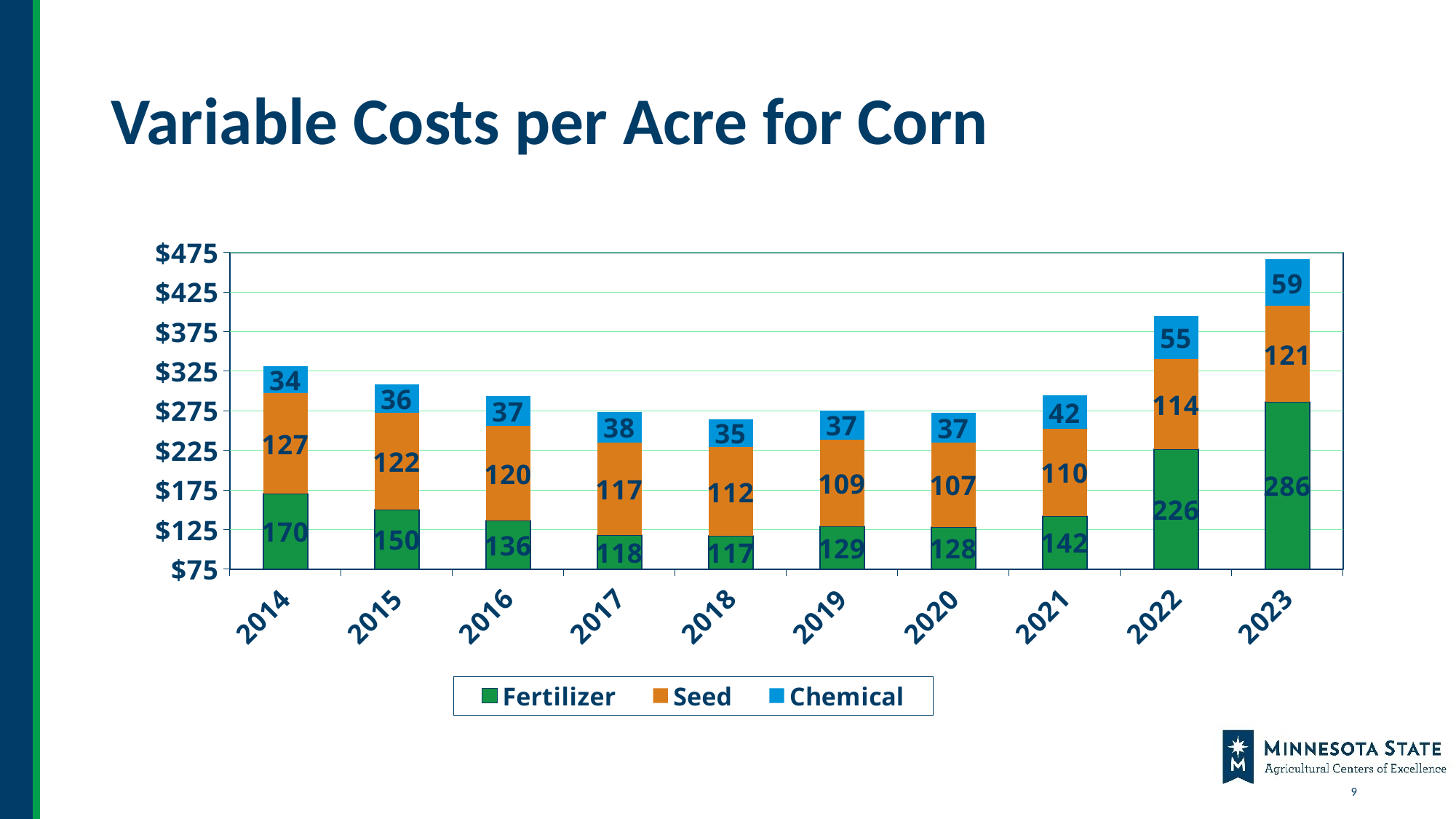
What is the total of the stacked bar for 2018? 264 What is the total of the stacked bar for 2023? 466 Which year has the highest Fertilizer value? 2023 How many years are shown on the x axis? 10 What is the Chemical value for 2021? 42 How many series does the legend list? 3 What is the Seed value for 2014? 127 What is the difference between the Fertilizer values for 2023 and 2022? 60 Which is larger, the Seed value for 2015 or the Seed value for 2016? 2015 Which year has the lowest Seed value? 2020 What is the Fertilizer value for 2023? 286 What kind of chart is shown on the slide? Stacked bar chart